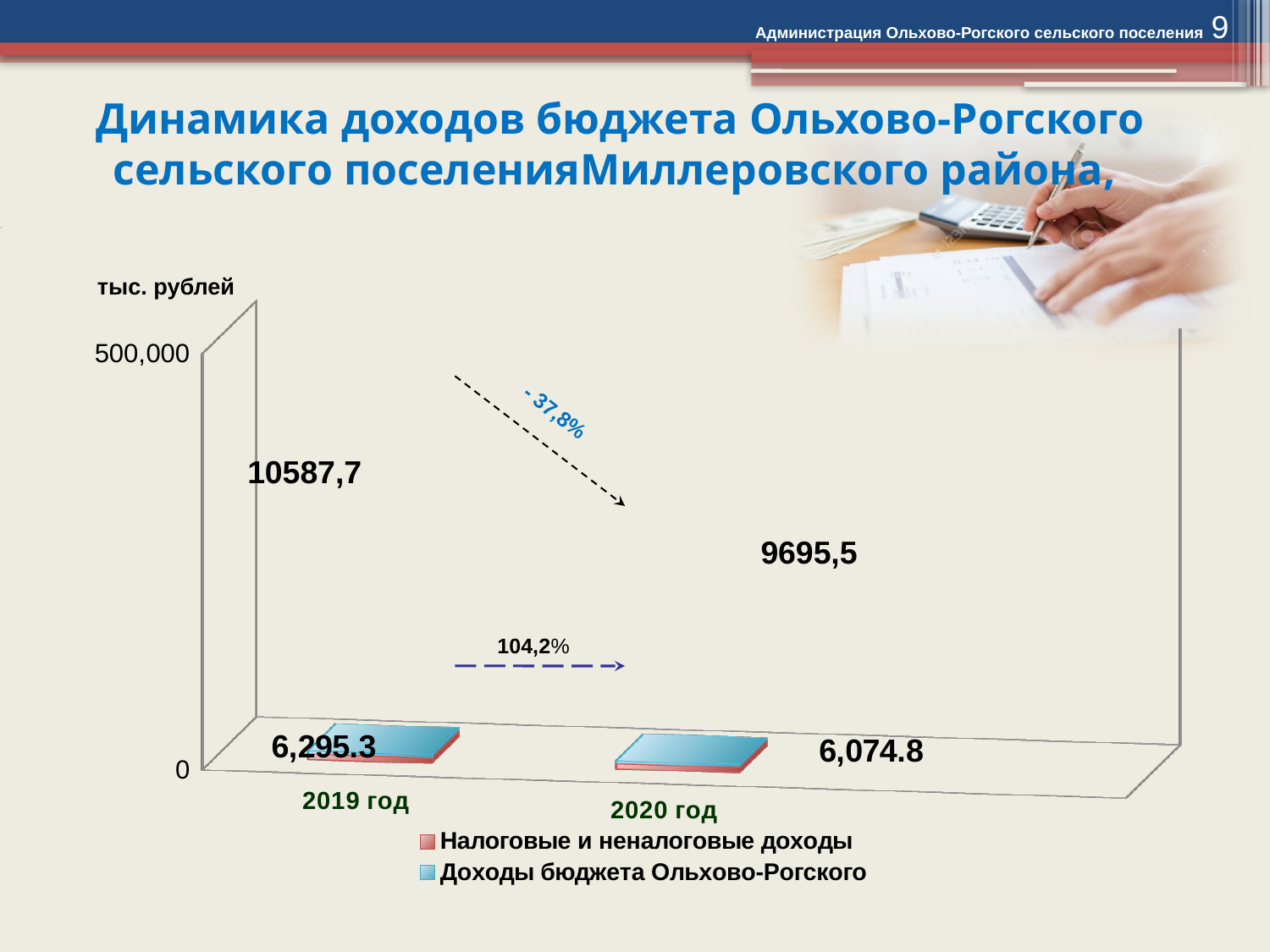
Which year has the larger value printed next to its bar, 2019 год or 2020 год? 2019 год What kind of chart is shown on the slide? bar chart What value is printed next to the bar for 2020 год? 6,074.8 How many categories (years) are shown on the x axis of the chart? 2 What percentage is written along the downward dashed arrow on the chart? - 37,8% What value is printed next to the bar for 2019 год? 6,295.3 How many series does the chart legend list? 2 What value is printed in the upper label above the 2020 год bar? 9695,5 What is the difference between the upper labels 10587,7 (2019 год) and 9695,5 (2020 год)? 892,2 What value is printed in the upper label above the 2019 год bar? 10587,7 Do the values printed next to the bars rise or fall from 2019 год to 2020 год? fall What is the difference between the bar labels 6,295.3 (2019 год) and 6,074.8 (2020 год)? 220.5